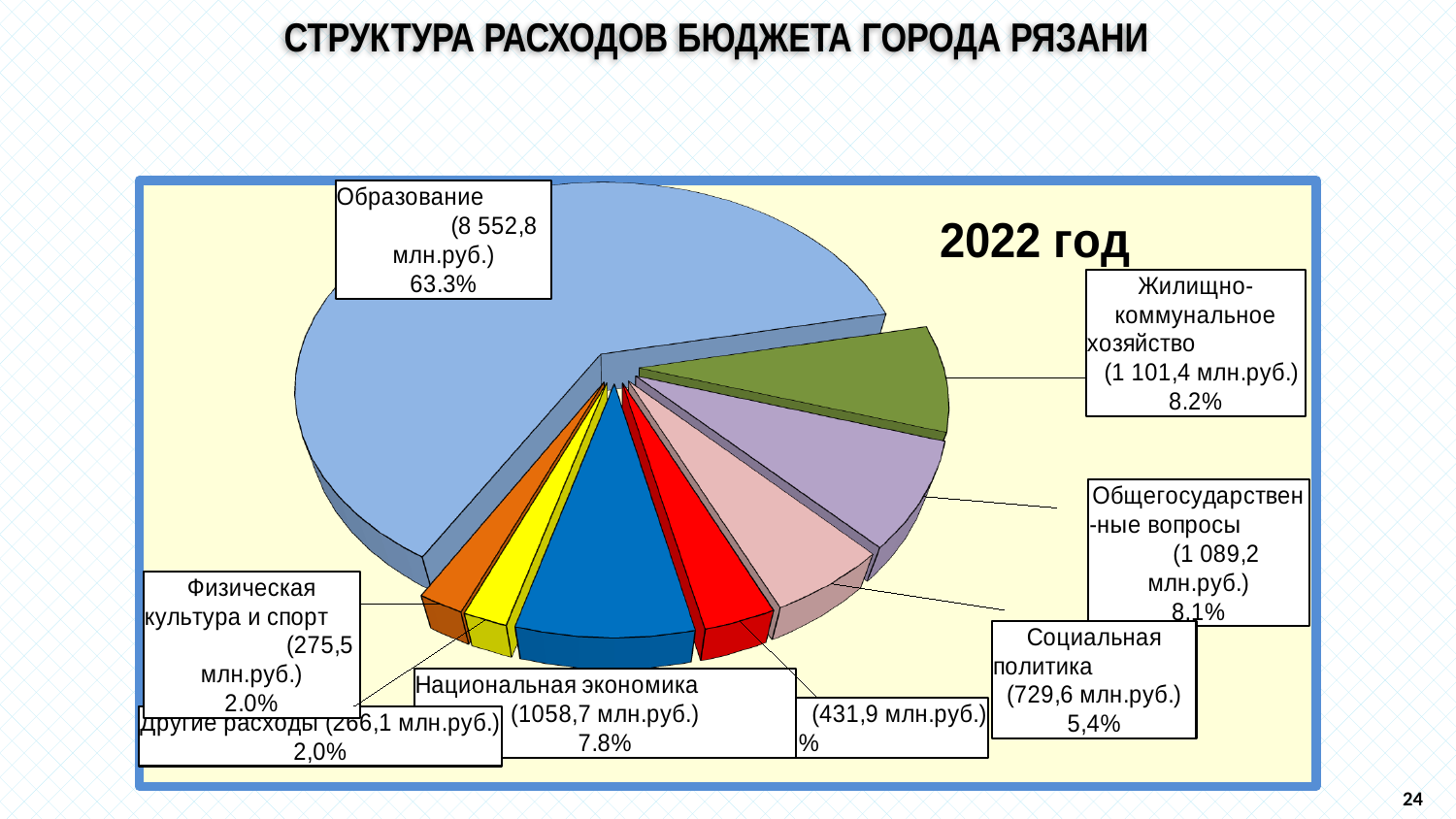
What is the title of the slide? СТРУКТУРА РАСХОДОВ БЮДЖЕТА ГОРОДА РЯЗАНИ What share of the budget expenditure does Образование account for? 63.3% What is the amount shown for Жилищно-коммунальное хозяйство? 1 101,4 млн.руб. How many slices does the pie chart have? 8 Which year does the chart refer to? 2022 год What is the difference in percentage points between Жилищно-коммунальное хозяйство (8.2%) and Национальная экономика (7.8%)? 0.4 Which is larger: the share for Жилищно-коммунальное хозяйство or for Общегосударственные вопросы? Жилищно-коммунальное хозяйство Which category has the largest share of the pie? Образование What is the amount shown for Физическая культура и спорт? 275,5 млн.руб. What is the amount shown for Национальная экономика? 1058,7 млн.руб. What percentage is shown for Социальная политика? 5.4% What kind of chart is shown on the slide? pie chart